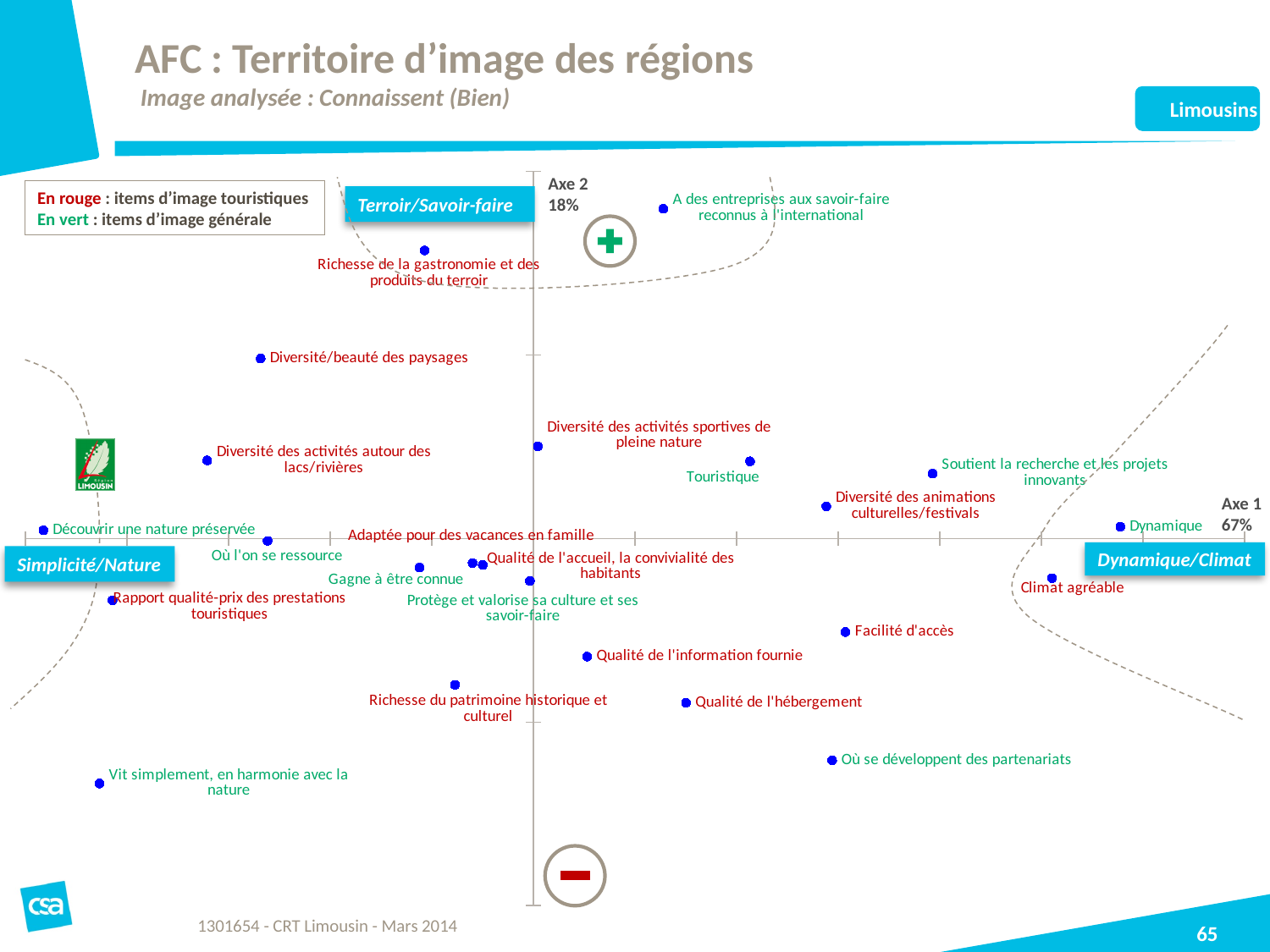
Which item is plotted higher on the vertical axis, "Diversité/beauté des paysages" or "Qualité de l'hébergement"? Diversité/beauté des paysages Which item is plotted furthest to the left on Axe 1? Découvrir une nature préservée Which item is plotted highest on Axe 2 (the vertical axis)? A des entreprises aux savoir-faire reconnus à l'international What percentage is shown for Axe 1? 67% What kind of chart is shown on the slide? scatter plot What label is given to the bottom-right zone of the map? Dynamique/Climat Which item is plotted higher on the vertical axis, "Richesse de la gastronomie et des produits du terroir" or "Climat agréable"? Richesse de la gastronomie et des produits du terroir According to the legend, what colour is used for the tourism image items (items d'image touristiques)? red Which item is plotted lowest on Axe 2 (the vertical axis)? Vit simplement, en harmonie avec la nature Which item is plotted furthest to the right on Axe 1? Dynamique What percentage is shown for Axe 2? 18% Which item is plotted further to the right, "Facilité d'accès" or "Richesse du patrimoine historique et culturel"? Facilité d'accès